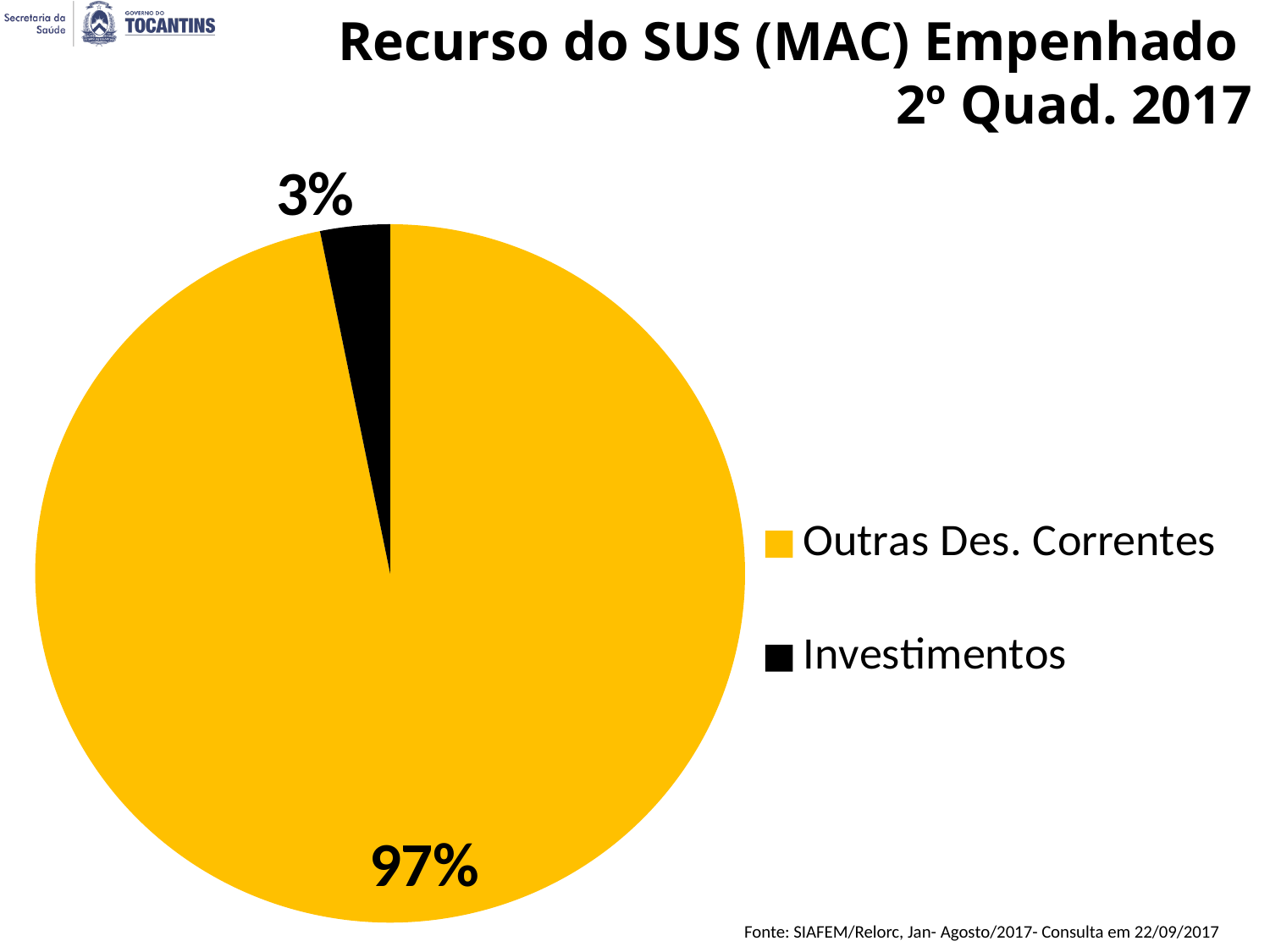
How many entries does the legend list? 2 What is the difference in percentage points between Outras Des. Correntes and Investimentos? 94 What share of the pie does Outras Des. Correntes represent? 97% What share of the pie does Investimentos represent? 3% What is the title of the chart? Recurso do SUS (MAC) Empenhado 2º Quad. 2017 What kind of chart is shown on the slide? pie chart How many categories does the pie chart show? 2 Which is larger, the slice for Outras Des. Correntes or the slice for Investimentos? Outras Des. Correntes What colour is the slice for Investimentos? black Which category has the smallest slice of the pie? Investimentos Which category has the largest slice of the pie? Outras Des. Correntes